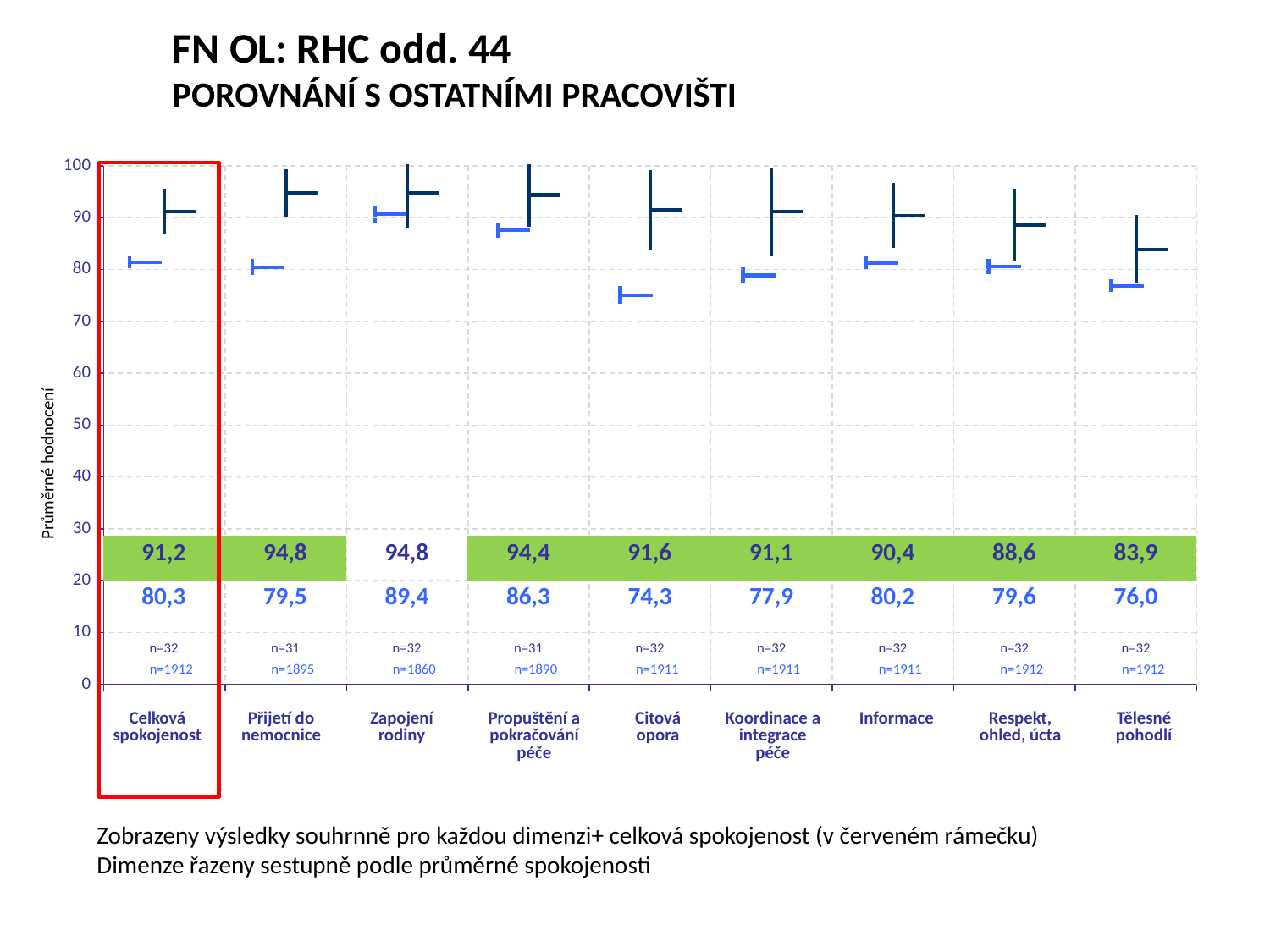
Is the light blue marker for Citová opora greater or less than 80? less Which category has the lowest light blue value (the row below the green band)? Citová opora Which category has the highest light blue value (the row below the green band)? Zapojení rodiny What is the difference between the green-band value and the light blue value for Tělesné pohodlí? 7,9 What is the difference between the green-band value and the light blue value for Celková spokojenost? 10,9 What is the light blue value printed below the green band for Zapojení rodiny? 89,4 What are the two n values printed for Zapojení rodiny? n=32, n=1860 What is the value printed in the green band for Celková spokojenost? 91,2 How many categories are shown along the x axis? 9 Which category has the lowest value in the green band? Tělesné pohodlí Which category is highlighted with a red frame? Celková spokojenost Which has the larger light blue value: Informace or Přijetí do nemocnice? Informace